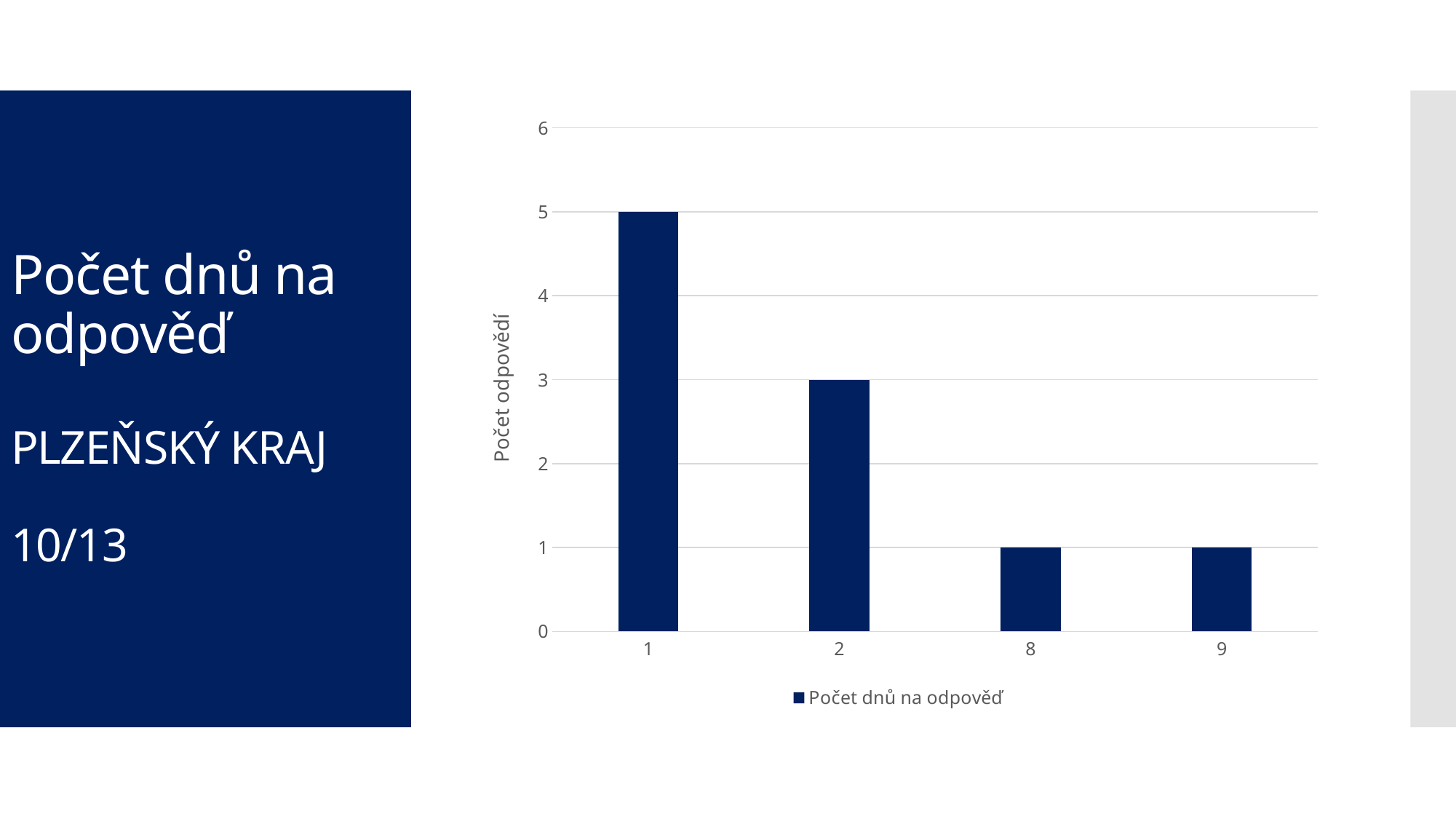
What is the value for category 9 in the chart? 1 Do the values rise or fall from left to right along the x axis? fall Which has the larger value, category 2 or category 8? 2 Which category has the highest value in the chart? 1 What is the difference between the values for category 1 and category 2? 2 How many categories are shown on the x axis of the chart? 4 What is the label of the series in the chart's legend? Počet dnů na odpověď How many series does the chart's legend list? 1 What is the value for category 8 in the chart? 1 What is the value for category 2 in the chart? 3 What is the value for category 1 in the chart? 5 What kind of chart is shown on the slide? bar chart